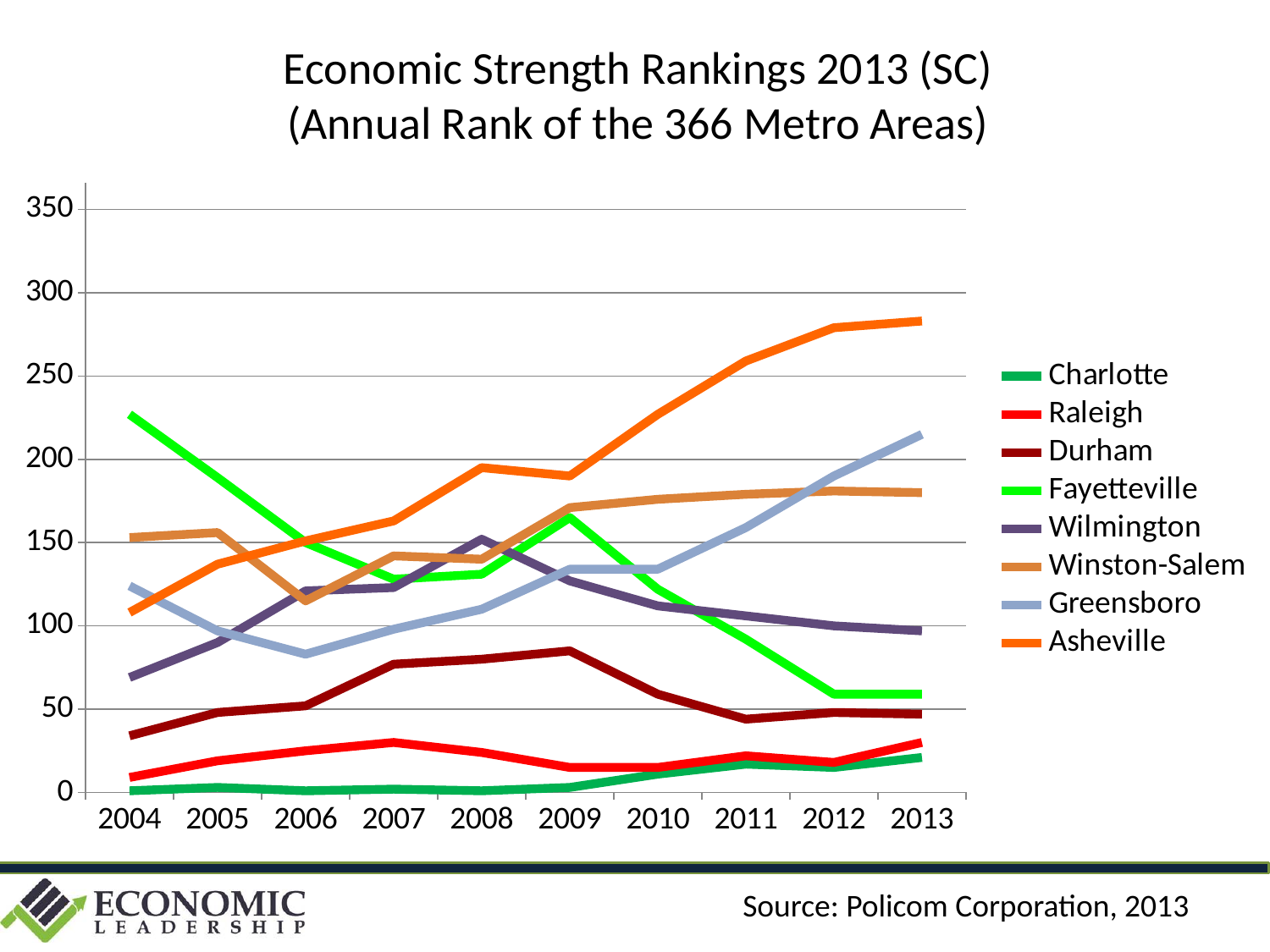
Does the Asheville line rise or fall from 2004 to 2013? rise Is the value for Fayetteville in 2013 greater or less than 100? less Is the value for Greensboro in 2006 greater or less than 100? less How many series does the legend list? 8 Is the value for Asheville in 2013 greater or less than 250? greater What kind of chart is shown on the slide? line chart Which metro area has the lowest value in 2004? Charlotte How many years are shown along the x axis? 10 Which metro area has the highest value in 2013? Asheville In 2013, which is higher, Greensboro or Winston-Salem? Greensboro Does the Fayetteville line rise or fall from 2004 to 2013? fall Which metro area has the highest value in 2004? Fayetteville